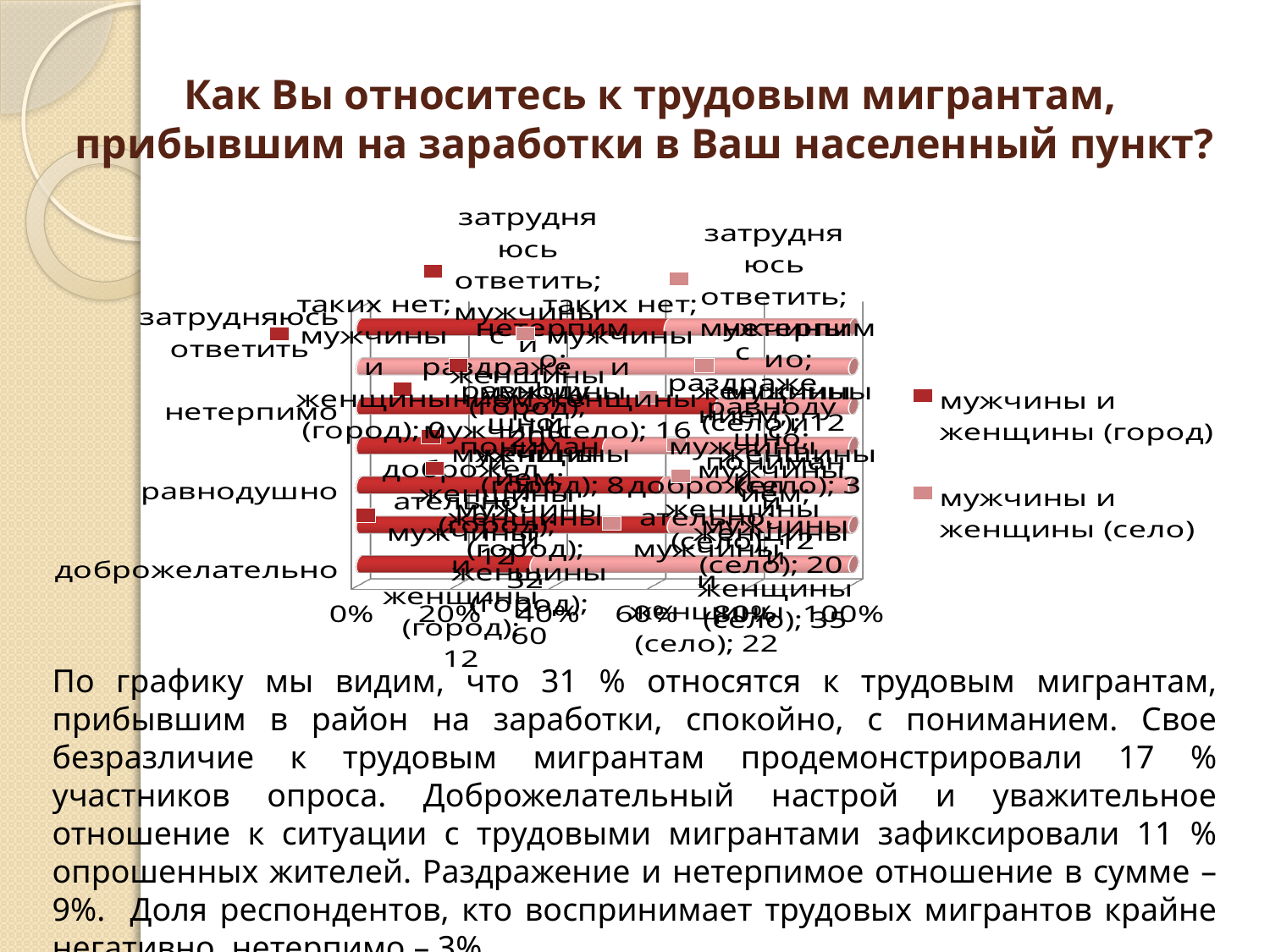
How many series does the chart legend list? 2 What kind of chart is shown on the slide? bar chart Which category label appears at the top of the chart's vertical axis? затрудняюсь ответить What are the two series named in the chart legend? мужчины и женщины (город); мужчины и женщины (село) What is the highest value shown on the chart's horizontal axis? 100% Which category label appears at the bottom of the chart's vertical axis? доброжелательно